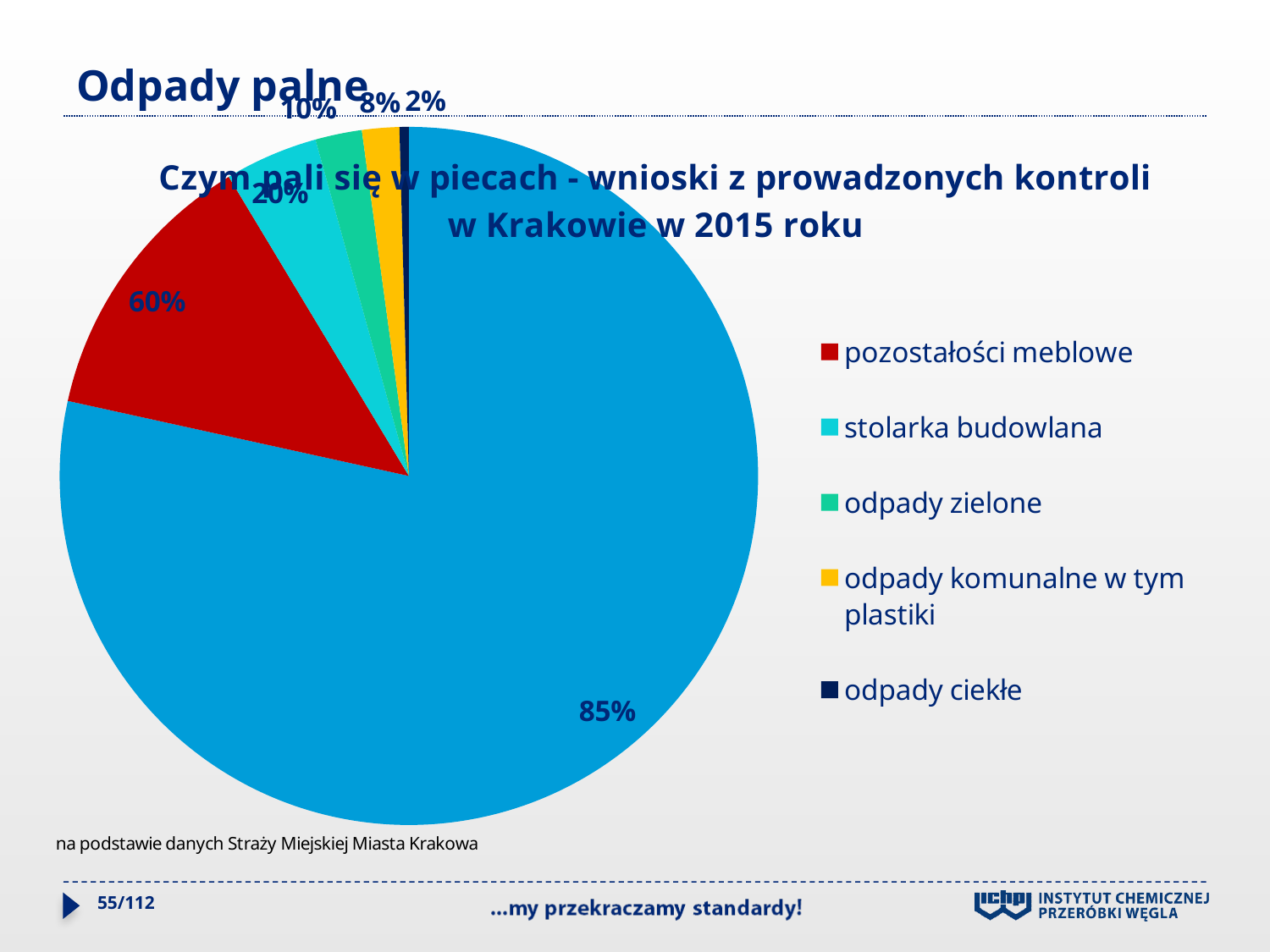
What value is labelled on the slice for stolarka budowlana? 20% What value is labelled on the slice for odpady komunalne w tym plastiki? 8% What value is labelled on the slice for odpady ciekłe? 2% How many entries does the chart legend list? 5 What value is labelled on the largest slice of the pie? 85% What value is labelled on the slice for odpady zielone? 10% How many slices does the pie chart have? 6 Which legend category has the smallest slice? odpady ciekłe What is the difference between the labelled values for pozostałości meblowe and stolarka budowlana? 40% What value is labelled on the slice for pozostałości meblowe? 60% What is the title of the chart? Czym pali się w piecach - wnioski z prowadzonych kontroli w Krakowie w 2015 roku What type of chart is shown on the slide? pie chart